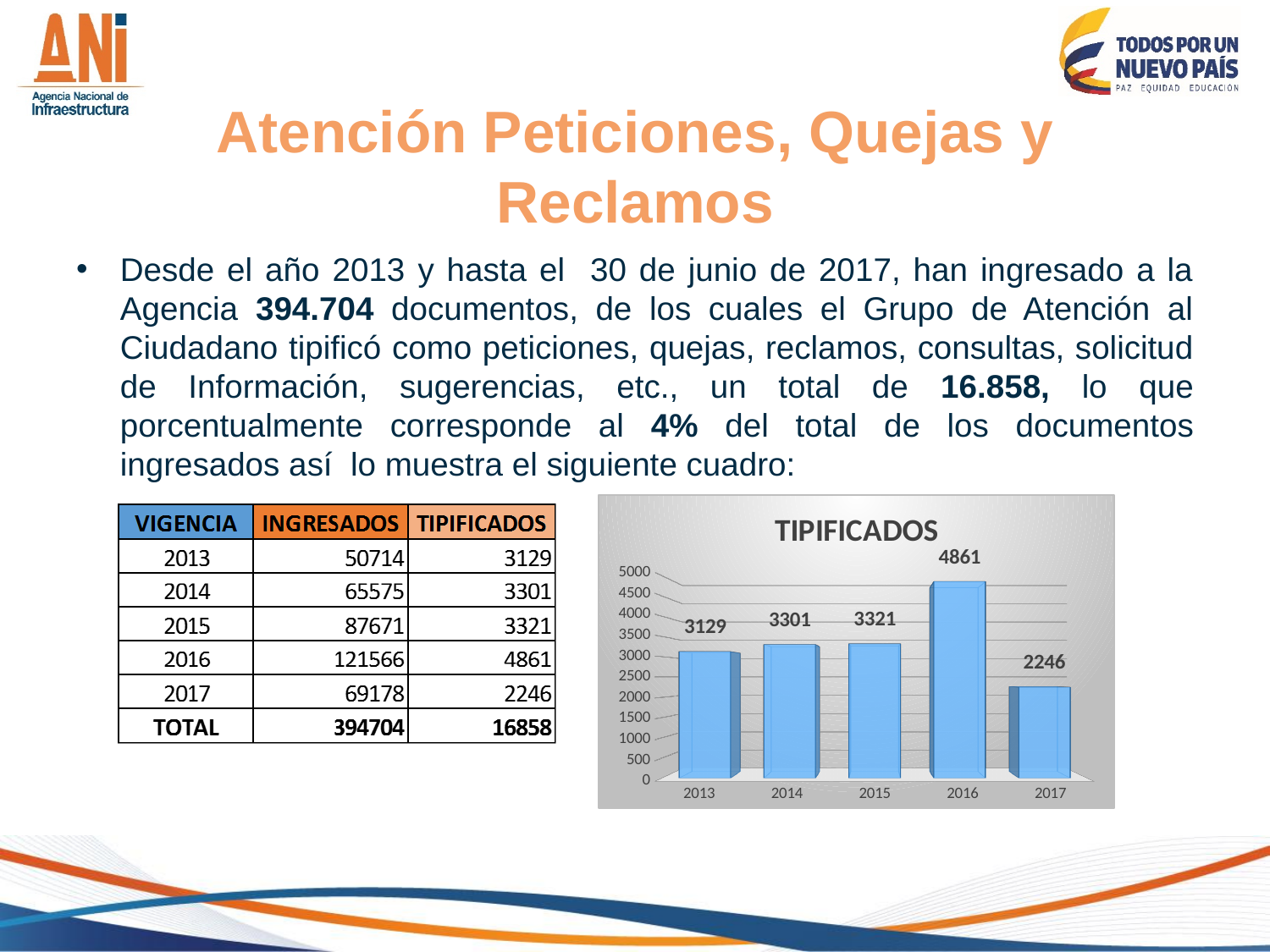
What is the difference between the values for 2014 and 2013 in the TIPIFICADOS chart? 172 How many years are shown on the x axis of the TIPIFICADOS chart? 5 What kind of chart is the TIPIFICADOS chart? bar chart What is the value for 2017 in the TIPIFICADOS chart? 2246 Which year has the lowest value in the TIPIFICADOS chart? 2017 What is the title of the chart on the slide? TIPIFICADOS What is the value for 2016 in the TIPIFICADOS chart? 4861 Which is larger in the TIPIFICADOS chart, the value for 2015 or the value for 2017? 2015 Is the value for 2016 in the TIPIFICADOS chart greater or less than 4500? greater What is the difference between the values for 2016 and 2017 in the TIPIFICADOS chart? 2615 What is the value for 2013 in the TIPIFICADOS chart? 3129 Which year has the highest value in the TIPIFICADOS chart? 2016